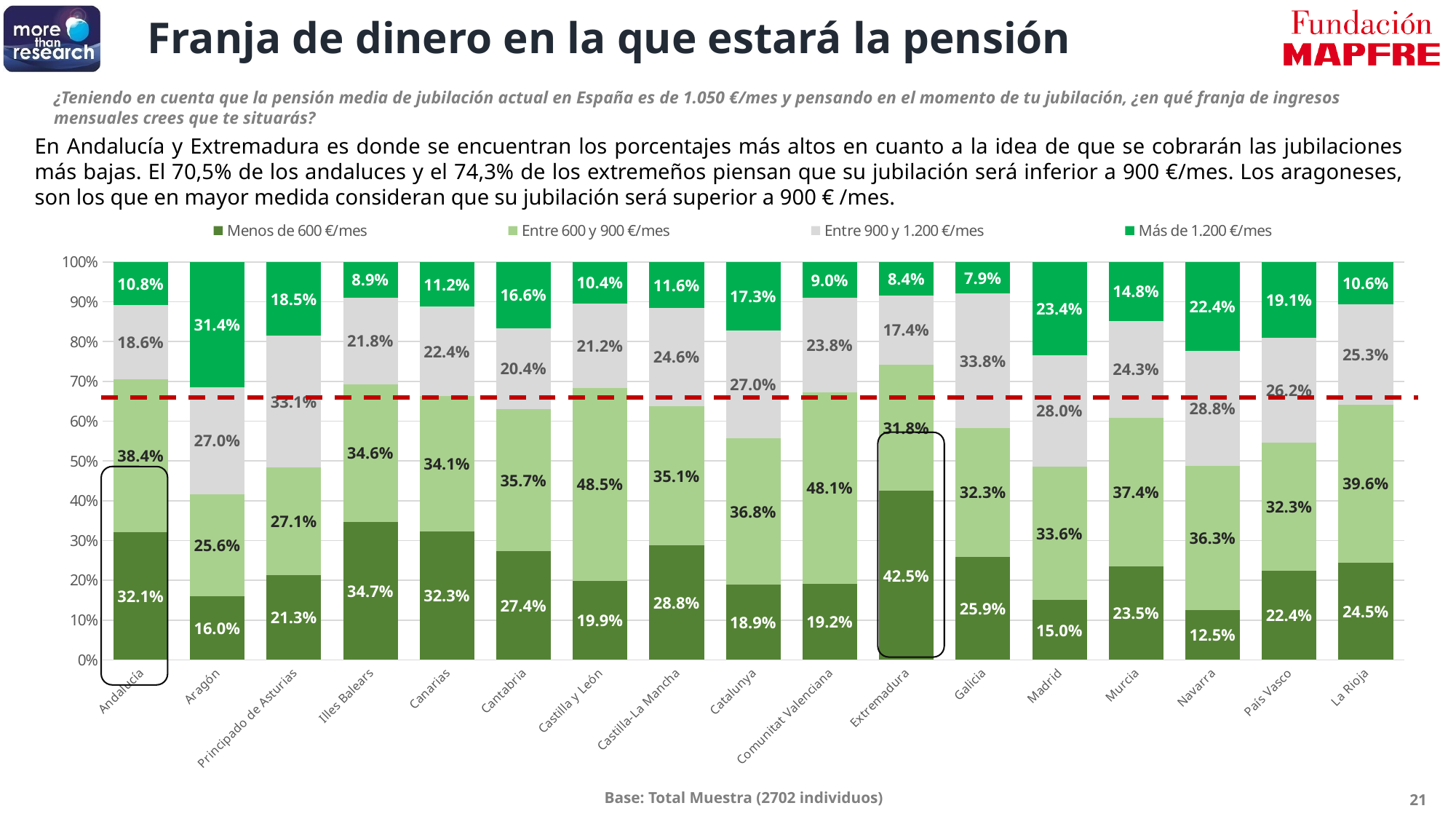
What is the value for Aragón in the 'Más de 1.200 €/mes' series? 31.4% Which region has the lowest value in the 'Más de 1.200 €/mes' series? Galicia Which region has the lowest value in the 'Menos de 600 €/mes' series? Navarra Which is larger: the 'Más de 1.200 €/mes' value for Madrid or for Navarra? Madrid What kind of chart is shown on the slide? Stacked bar chart Which region has the highest value in the 'Más de 1.200 €/mes' series? Aragón How many series does the legend list? 4 What is the 'Entre 600 y 900 €/mes' value for Castilla y León? 48.5% Which region has the highest value in the 'Menos de 600 €/mes' series? Extremadura How many regions are shown on the x axis of the chart? 17 What is the difference in percentage points between Extremadura and Andalucía in the 'Menos de 600 €/mes' series? 10.4 What percentage of respondents in Extremadura expect a pension of 'Menos de 600 €/mes'? 42.5%